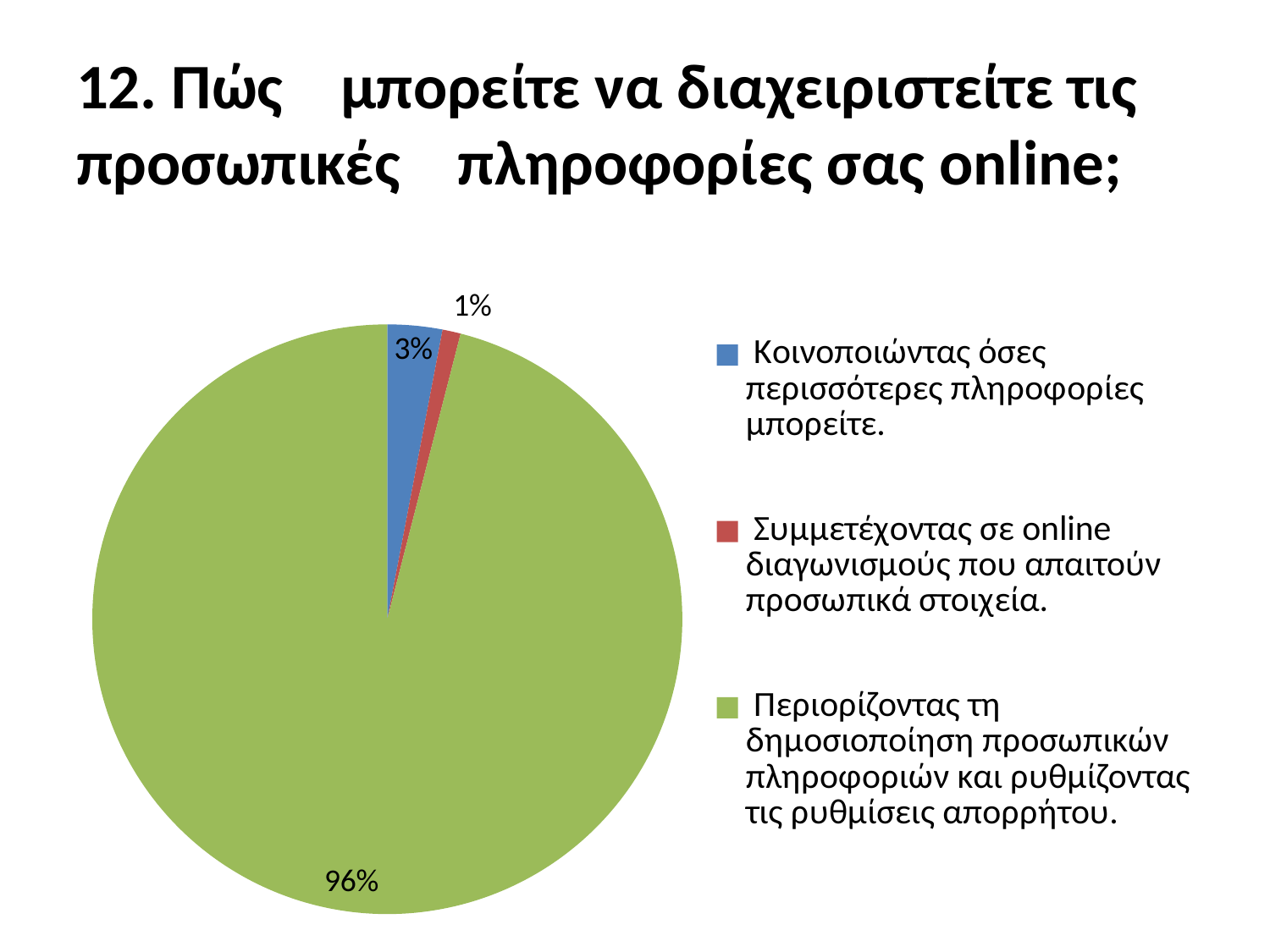
Which category has the smallest slice of the pie? Συμμετέχοντας σε online διαγωνισμούς που απαιτούν προσωπικά στοιχεία. What share of the pie is 'Κοινοποιώντας όσες περισσότερες πληροφορίες μπορείτε.'? 3% What colour is the slice for 'Περιορίζοντας τη δημοσιοποίηση προσωπικών πληροφοριών και ρυθμίζοντας τις ρυθμίσεις απορρήτου.'? green What kind of chart is shown on the slide? pie chart What share of the pie is 'Συμμετέχοντας σε online διαγωνισμούς που απαιτούν προσωπικά στοιχεία.'? 1% What share of the pie is 'Περιορίζοντας τη δημοσιοποίηση προσωπικών πληροφοριών και ρυθμίζοντας τις ρυθμίσεις απορρήτου.'? 96% Which category has the largest slice of the pie? Περιορίζοντας τη δημοσιοποίηση προσωπικών πληροφοριών και ρυθμίζοντας τις ρυθμίσεις απορρήτου. What is the title of the slide containing the pie chart? 12. Πώς μπορείτε να διαχειριστείτε τις προσωπικές πληροφορίες σας online; How many slices does the pie chart have? 3 Which is larger: the slice for 'Κοινοποιώντας όσες περισσότερες πληροφορίες μπορείτε.' or the slice for 'Συμμετέχοντας σε online διαγωνισμούς που απαιτούν προσωπικά στοιχεία.'? Κοινοποιώντας όσες περισσότερες πληροφορίες μπορείτε. How many entries does the legend list? 3 What is the difference in percentage points between the largest slice and the 'Κοινοποιώντας όσες περισσότερες πληροφορίες μπορείτε.' slice? 93